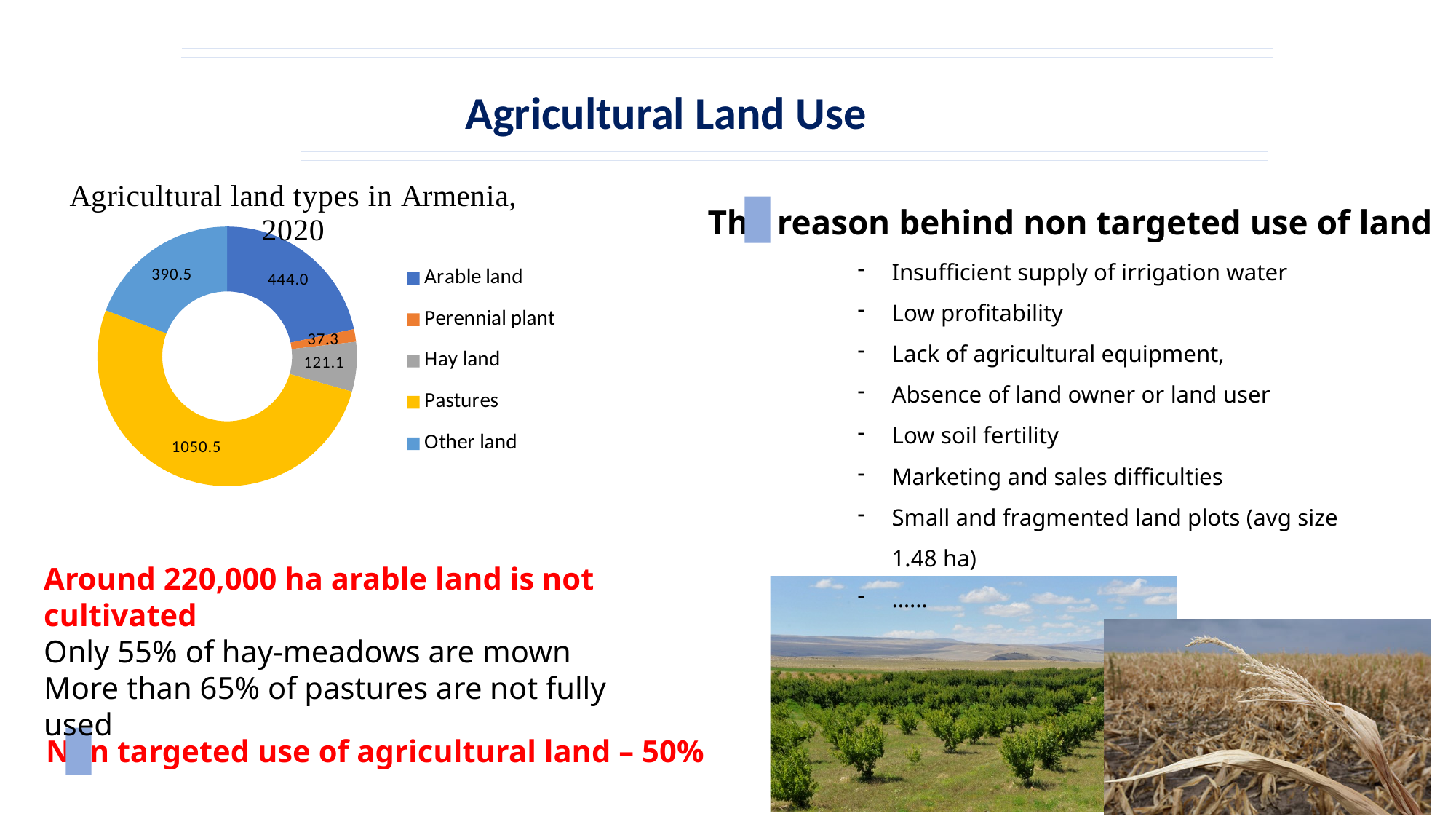
What value is shown for Pastures in the 'Agricultural land types in Armenia, 2020' chart? 1050.5 What value is shown for Perennial plant in the chart? 37.3 What kind of chart is used to show agricultural land types in Armenia? Doughnut (pie) chart How many land types are shown in the chart? 5 What is the difference between the values for Pastures and Arable land? 606.5 What is the title of the chart on the slide? Agricultural land types in Armenia, 2020 What value is shown for Hay land in the chart? 121.1 Which land type has the smallest value in the chart? Perennial plant What value is shown for Other land in the chart? 390.5 Which is larger, the value for Arable land or the value for Other land? Arable land Which land type has the largest value in the chart? Pastures What value is shown for Arable land in the chart? 444.0